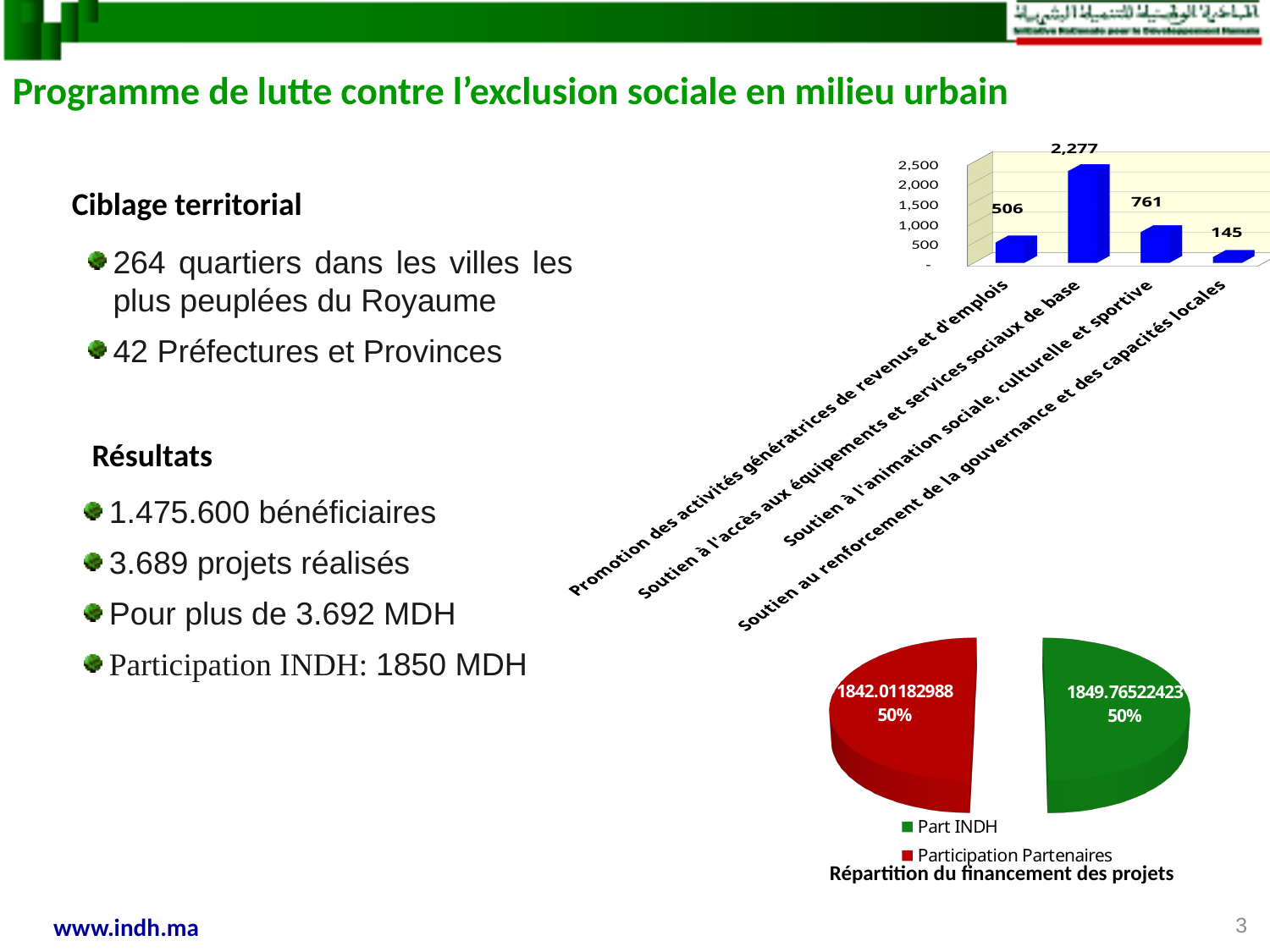
In the chart titled 'Répartition du financement des projets', what share of the pie does 'Participation Partenaires' represent? 50% In the chart titled 'Répartition du financement des projets', what value is shown for 'Part INDH'? 1849.76522423 In the bar chart at the top right, which is larger: the value for 'Soutien à l'animation sociale, culturelle et sportive' or for 'Promotion des activités génératrices de revenus et d'emplois'? Soutien à l'animation sociale, culturelle et sportive In the bar chart at the top right, what is the value for 'Soutien au renforcement de la gouvernance et des capacités locales'? 145 In the bar chart at the top right, which category has the lowest value? Soutien au renforcement de la gouvernance et des capacités locales How many categories are shown in the bar chart at the top right? 4 In the bar chart at the top right, is the value for 'Soutien à l'animation sociale, culturelle et sportive' greater or less than 1,000? less In the bar chart at the top right, which category has the highest value? Soutien à l'accès aux équipements et services sociaux de base In the bar chart at the top right, what is the value for 'Promotion des activités génératrices de revenus et d'emplois'? 506 In the bar chart at the top right, what is the value for 'Soutien à l'accès aux équipements et services sociaux de base'? 2,277 In the bar chart at the top right, what is the difference between the values for 'Soutien à l'accès aux équipements et services sociaux de base' and 'Soutien à l'animation sociale, culturelle et sportive'? 1,516 What kind of chart is the chart titled 'Répartition du financement des projets'? pie chart